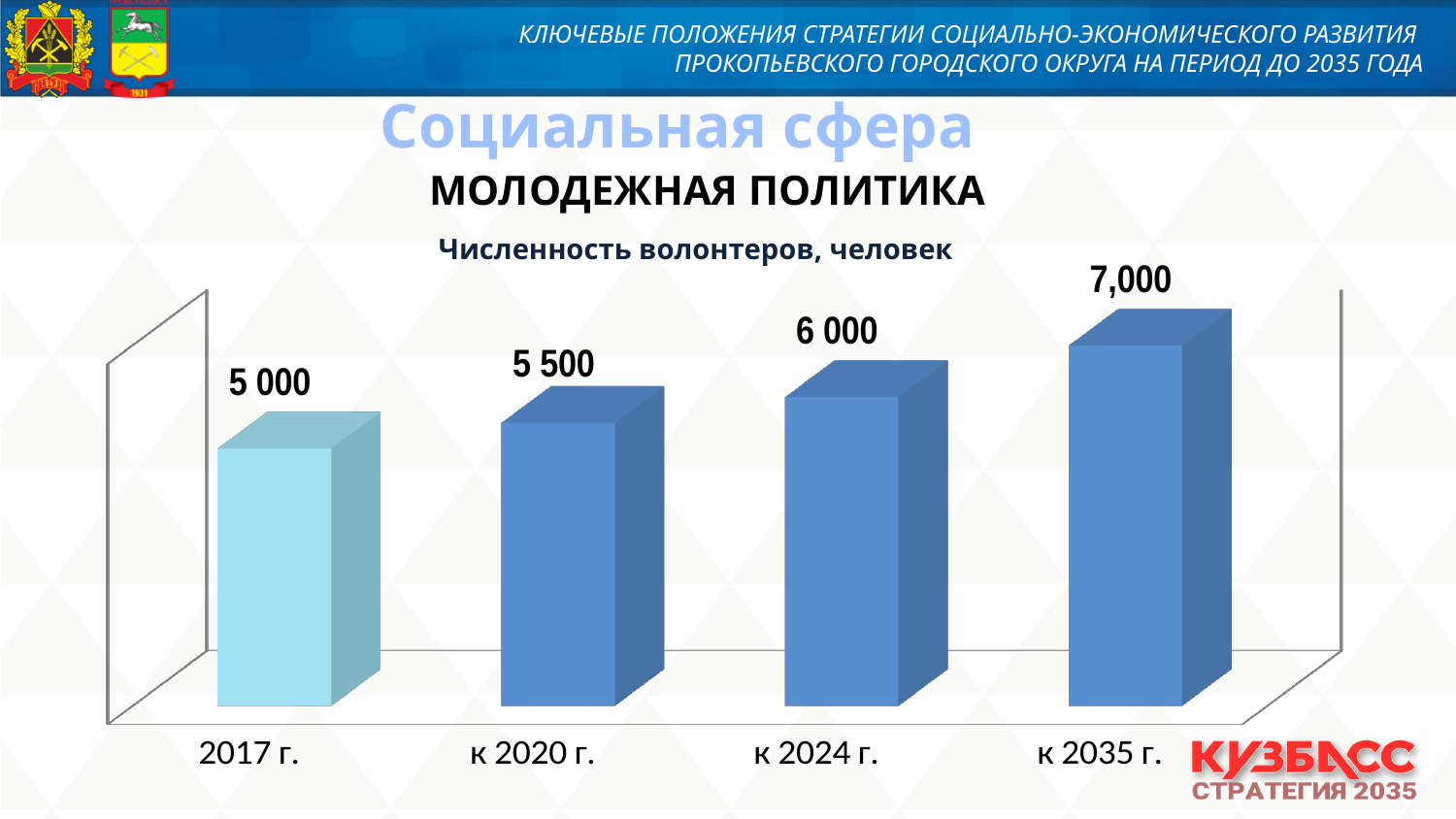
How many categories are shown on the chart? 4 What value is shown for к 2020 г.? 5 500 What is the number of volunteers shown for 2017 г.? 5 000 What kind of chart is shown on the slide? Bar chart What is the difference between the values for к 2035 г. and 2017 г.? 2 000 Which category has the lowest number of volunteers? 2017 г. Which is larger, the value for к 2020 г. or the value for к 2024 г.? к 2024 г. Which category has the highest number of volunteers? к 2035 г. What value is shown for к 2024 г.? 6 000 What is the difference between the values for к 2024 г. and к 2020 г.? 500 What value is shown for к 2035 г.? 7,000 Do the values rise or fall from 2017 г. to к 2035 г.? Rise